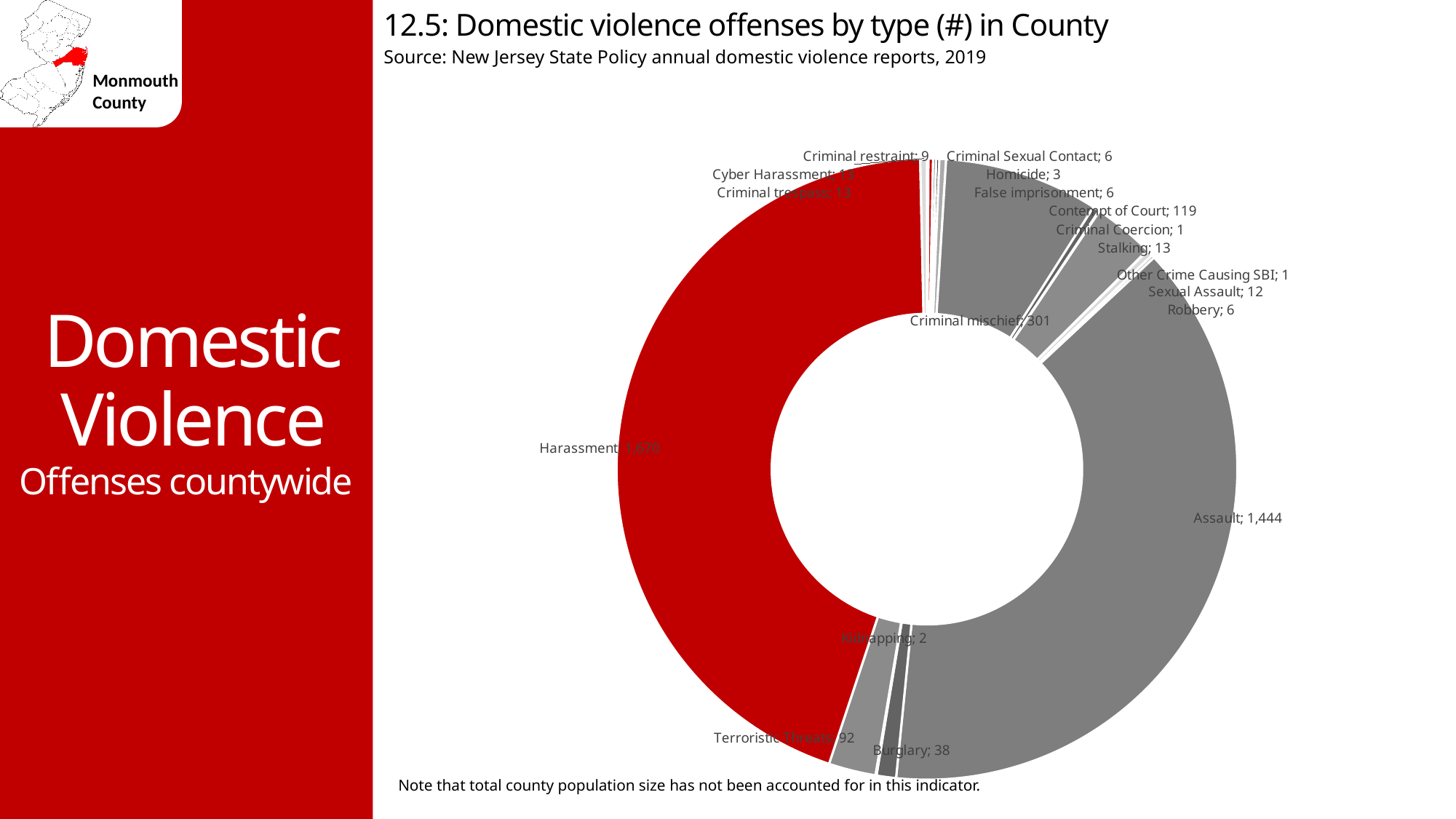
What kind of chart is shown on the slide? doughnut chart What is the difference between the Assault and Criminal mischief values? 1,143 Which is larger, Contempt of Court or Terroristic Threats? Contempt of Court What is the value for Contempt of Court? 119 What is the value for Homicide? 3 What is the value for Terroristic Threats? 92 How many domestic violence offenses of type Assault are shown? 1,444 What is the value for Burglary? 38 How many offense types are shown in the chart? 18 Which offense type has the largest slice of the chart? Harassment What is the value for Sexual Assault? 12 What is the value for Criminal mischief? 301